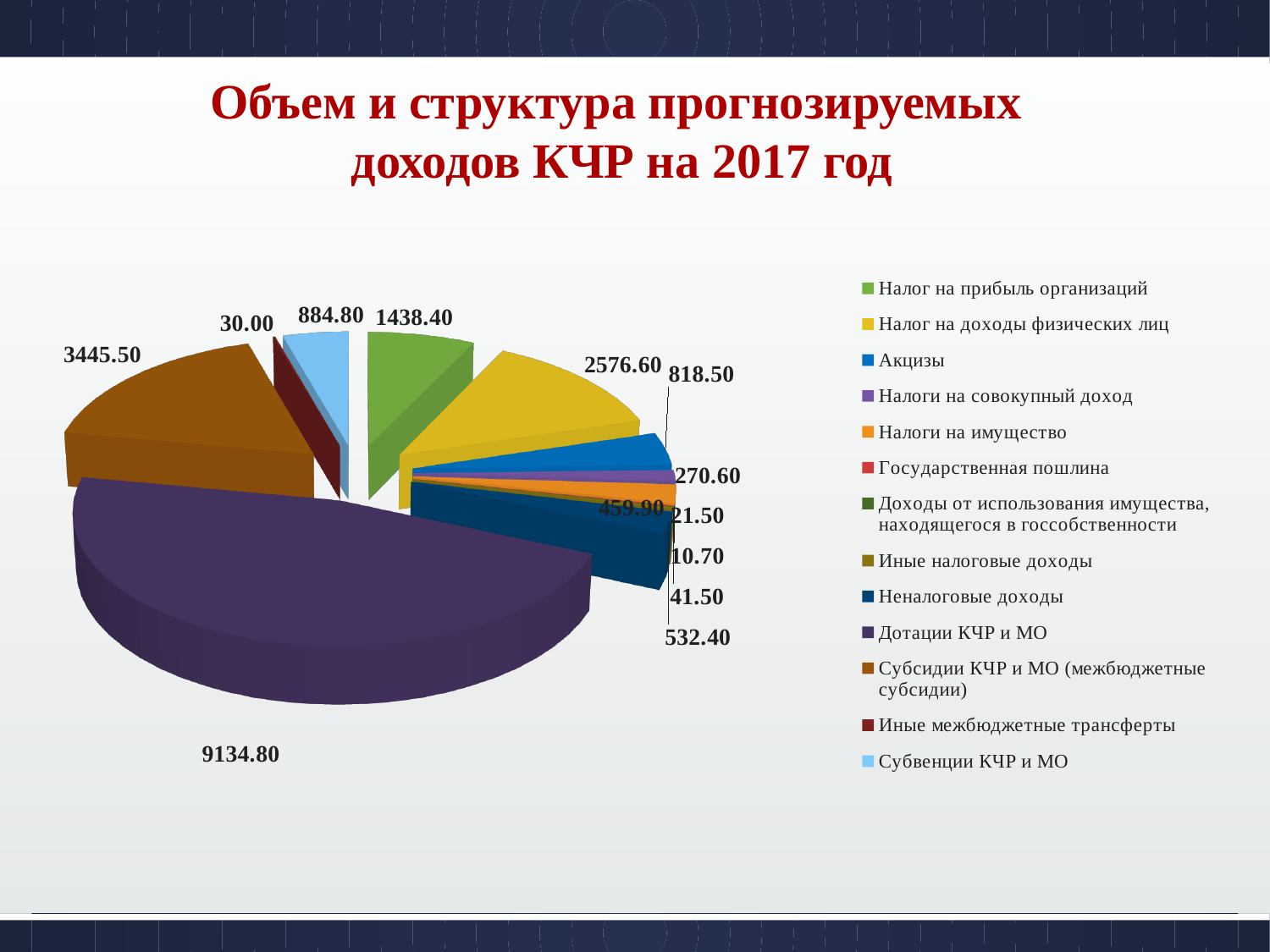
What is the value for Налог на прибыль организаций? 1438.40 What is the difference between the values for Дотации КЧР и МО and Субсидии КЧР и МО (межбюджетные субсидии)? 5689.30 What is the value for Субвенции КЧР и МО? 884.80 What kind of chart is shown on the slide? pie chart What is the value for Налог на доходы физических лиц? 2576.60 What is the value for Субсидии КЧР и МО (межбюджетные субсидии)? 3445.50 What is the value for Дотации КЧР и МО? 9134.80 How many categories does the legend of the pie chart list? 13 Which is larger, the value for Налог на доходы физических лиц or the value for Налог на прибыль организаций? Налог на доходы физических лиц Which category has the largest slice of the pie? Дотации КЧР и МО What is the smallest value labelled on the pie chart? 10.70 What is the title of the chart on the slide? Объем и структура прогнозируемых доходов КЧР на 2017 год